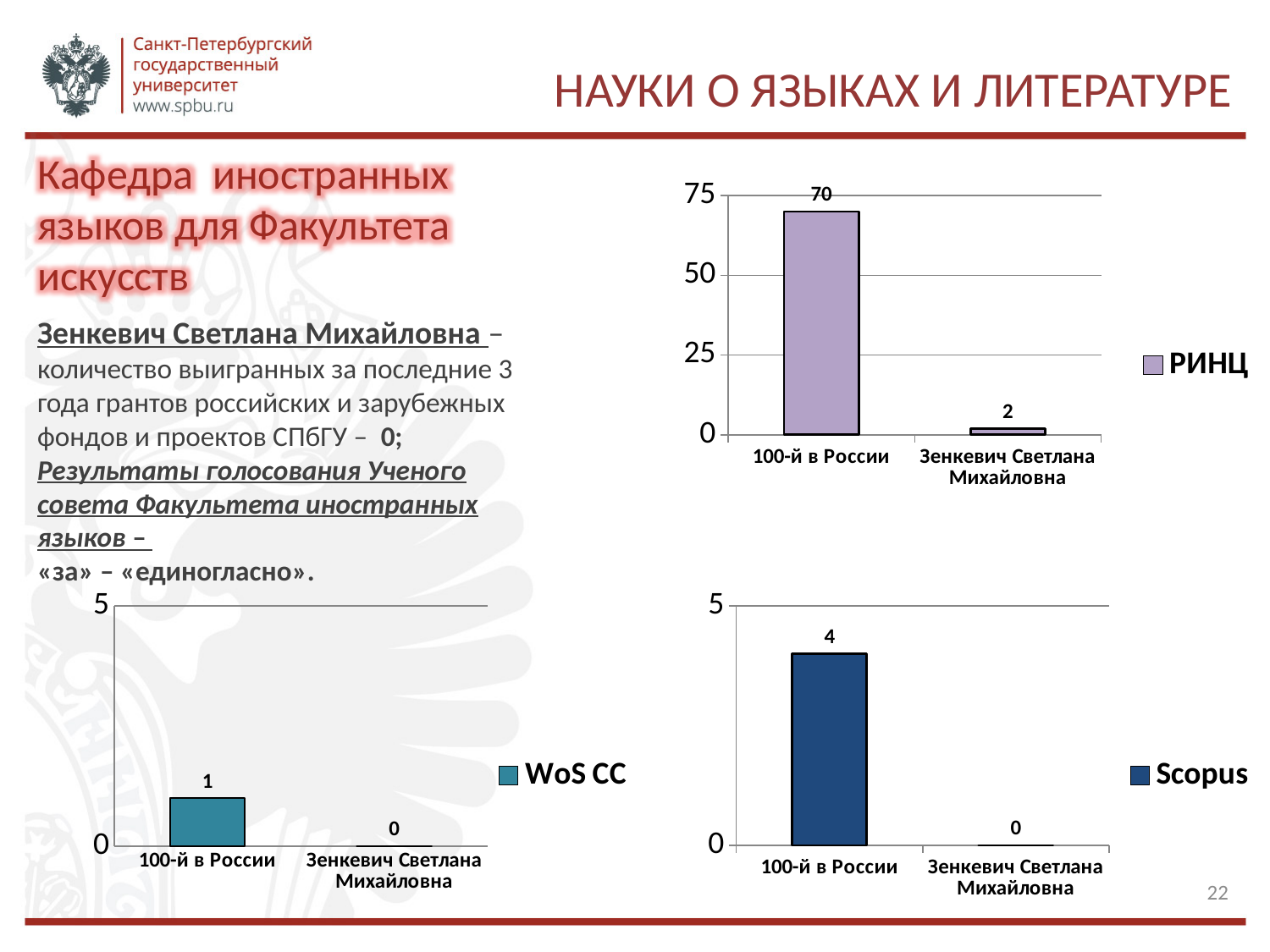
In the Scopus chart (bottom right), which category has the higher value? 100-й в России What series name does the legend of the top right chart show? РИНЦ What kind of chart is the Scopus chart (bottom right)? bar chart How many categories are shown on the x axis of the WoS CC chart (bottom left)? 2 In the РИНЦ chart (top right), what is the value for "100-й в России"? 70 In the WoS CC chart (bottom left), what is the value for "Зенкевич Светлана Михайловна"? 0 In the Scopus chart (bottom right), what is the value for "100-й в России"? 4 In the РИНЦ chart (top right), is the value for "100-й в России" greater or less than 50? greater In the Scopus chart (bottom right), what is the value for "Зенкевич Светлана Михайловна"? 0 In the WoS CC chart (bottom left), what is the value for "100-й в России"? 1 In the РИНЦ chart (top right), what is the value for "Зенкевич Светлана Михайловна"? 2 In the РИНЦ chart (top right), what is the difference between the values for "100-й в России" and "Зенкевич Светлана Михайловна"? 68